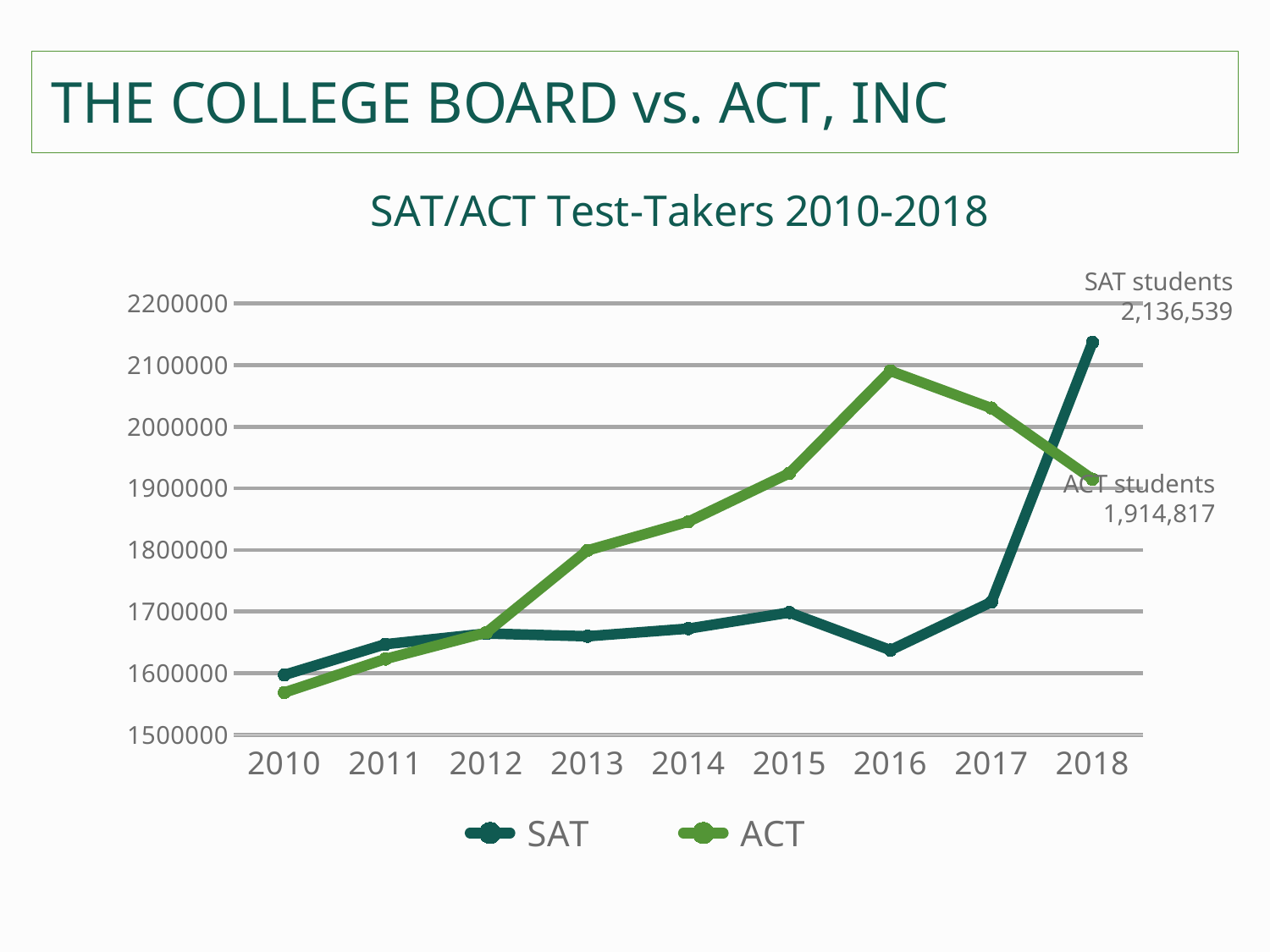
In which year does the ACT series reach its highest value? 2016 What is the number of ACT students in 2018? 1,914,817 What kind of chart is shown on the slide? line chart How many years are plotted along the x axis? 9 What is the difference between the SAT and ACT student counts in 2018? 221,722 What is the number of SAT students in 2018? 2,136,539 In 2013, which series has the larger value, SAT or ACT? ACT In 2018, which series has the larger value, SAT or ACT? SAT Is the value for ACT in 2016 greater or less than 2000000? greater Does the ACT series rise or fall from 2016 to 2018? fall How many series does the legend list? 2 Is the value for SAT in 2016 greater or less than 1700000? less